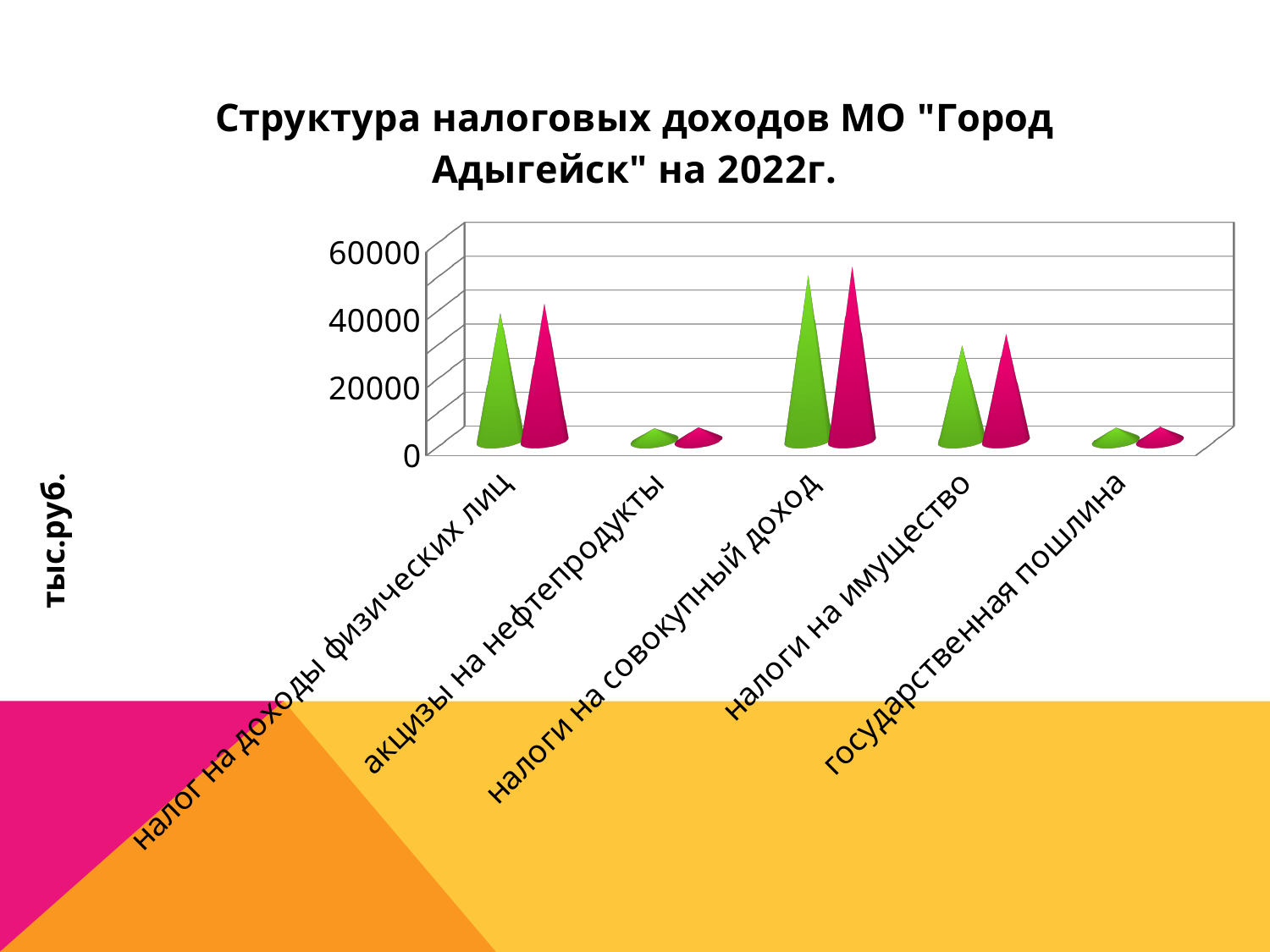
What is the title of the chart? Структура налоговых доходов МО "Город Адыгейск" на 2022г. What unit label is shown on the vertical axis of the chart? тыс.руб. Is the value of the green cone for налог на доходы физических лиц greater or less than 20000? greater Which category has the highest values in the chart? налоги на совокупный доход Is the value of the pink cone for налоги на совокупный доход greater or less than 60000? less Is the value of the green cone for акцизы на нефтепродукты greater or less than 20000? less What kind of chart is shown on the slide? bar chart How many categories are shown on the x axis of the chart? 5 Which category has larger values: налог на доходы физических лиц or налоги на имущество? налог на доходы физических лиц Which category has larger values: налоги на совокупный доход or налог на доходы физических лиц? налоги на совокупный доход